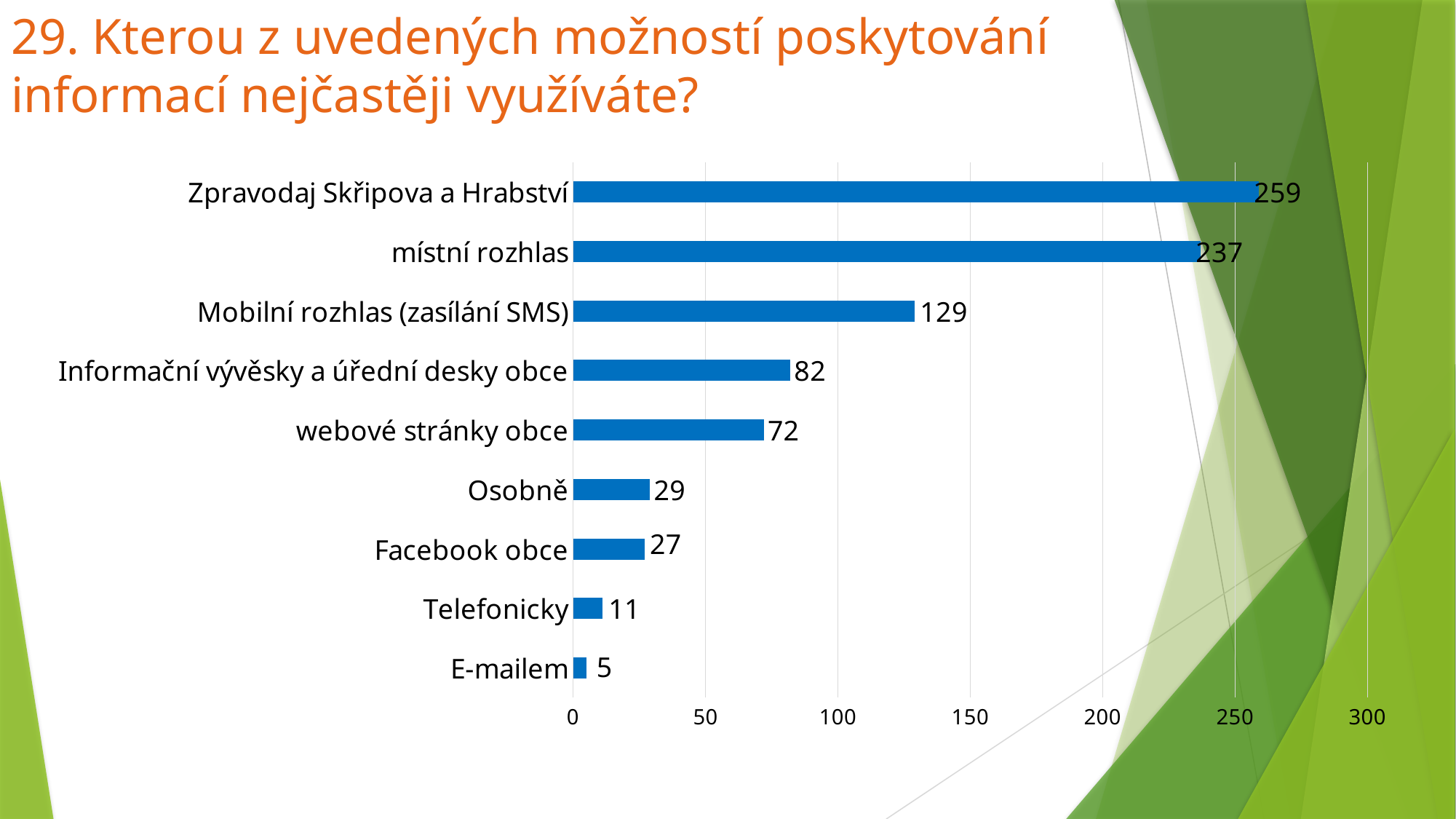
What is the value for webové stránky obce? 72 Is the value for místní rozhlas greater or less than 200? greater What is the difference between the values for Zpravodaj Skřipova a Hrabství and místní rozhlas? 22 What is the value for Mobilní rozhlas (zasílání SMS)? 129 How many categories are shown in the chart? 9 Which is larger, the value for Osobně or the value for Facebook obce? Osobně Which category has the lowest value? E-mailem What kind of chart is shown on the slide? bar chart What is the value for Telefonicky? 11 What is the value for Zpravodaj Skřipova a Hrabství? 259 Which category has the highest value? Zpravodaj Skřipova a Hrabství What is the difference between the values for Informační vývěsky a úřední desky obce and webové stránky obce? 10